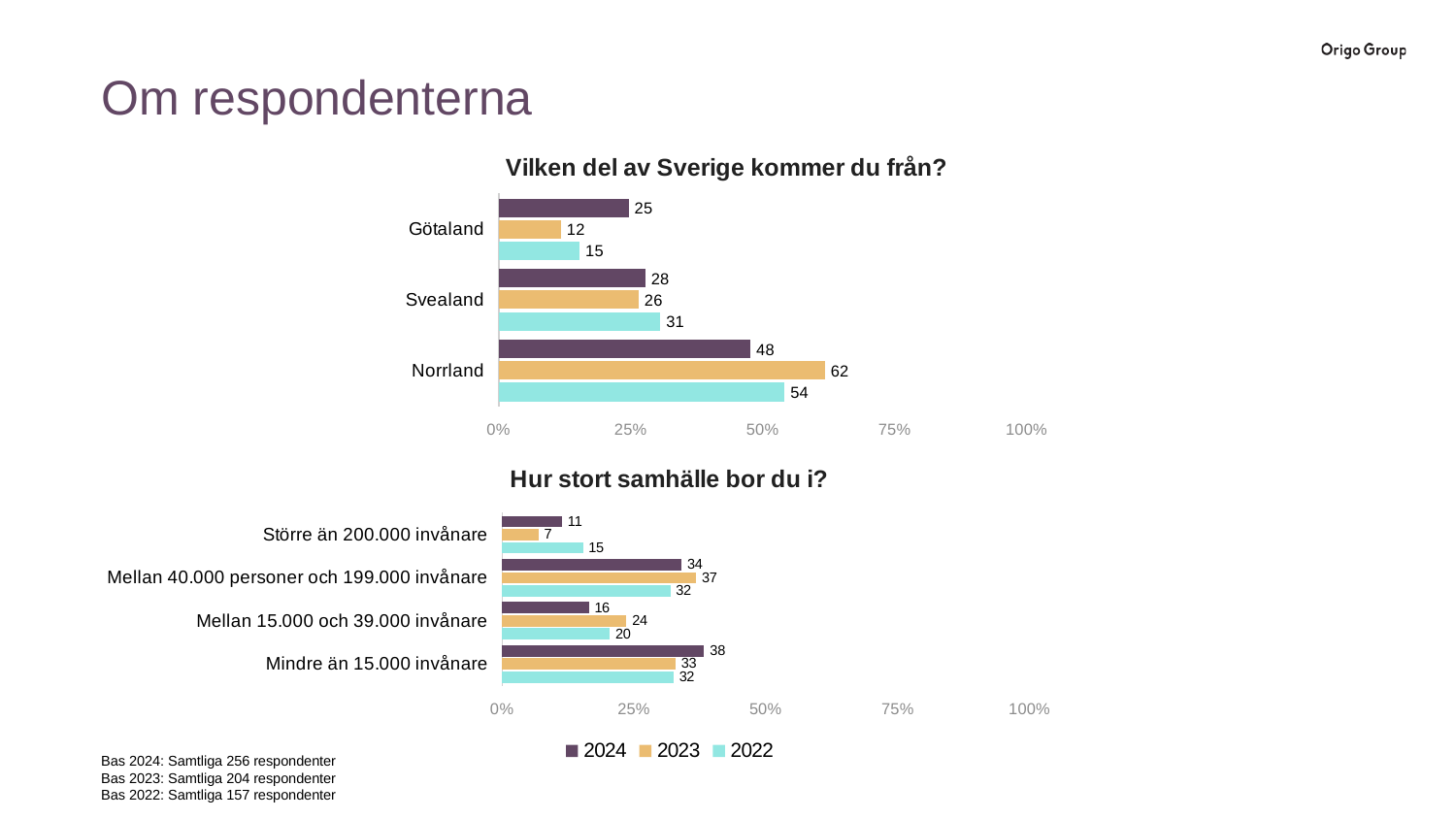
In the chart 'Vilken del av Sverige kommer du från?', which region has the highest value for 2024? Norrland In the chart 'Hur stort samhälle bor du i?', what is the value for 'Mindre än 15.000 invånare' in 2024? 38 What type of chart is 'Hur stort samhälle bor du i?'? Bar chart In the chart 'Vilken del av Sverige kommer du från?', what is the value for Götaland in 2022? 15 In the chart 'Vilken del av Sverige kommer du från?', what is the difference between the 2023 and 2024 values for Norrland? 14 In the chart 'Vilken del av Sverige kommer du från?', how many regions are shown? 3 In the chart 'Vilken del av Sverige kommer du från?', what is the value for Norrland in 2023? 62 In the chart 'Vilken del av Sverige kommer du från?', which region has the lowest value for 2023? Götaland In the chart 'Hur stort samhälle bor du i?', how many categories are shown? 4 How many series does the legend list? 3 In the chart 'Hur stort samhälle bor du i?', what is the value for 'Större än 200.000 invånare' in 2023? 7 In the chart 'Hur stort samhälle bor du i?', which is larger for 'Mellan 15.000 och 39.000 invånare': the 2023 value or the 2024 value? 2023